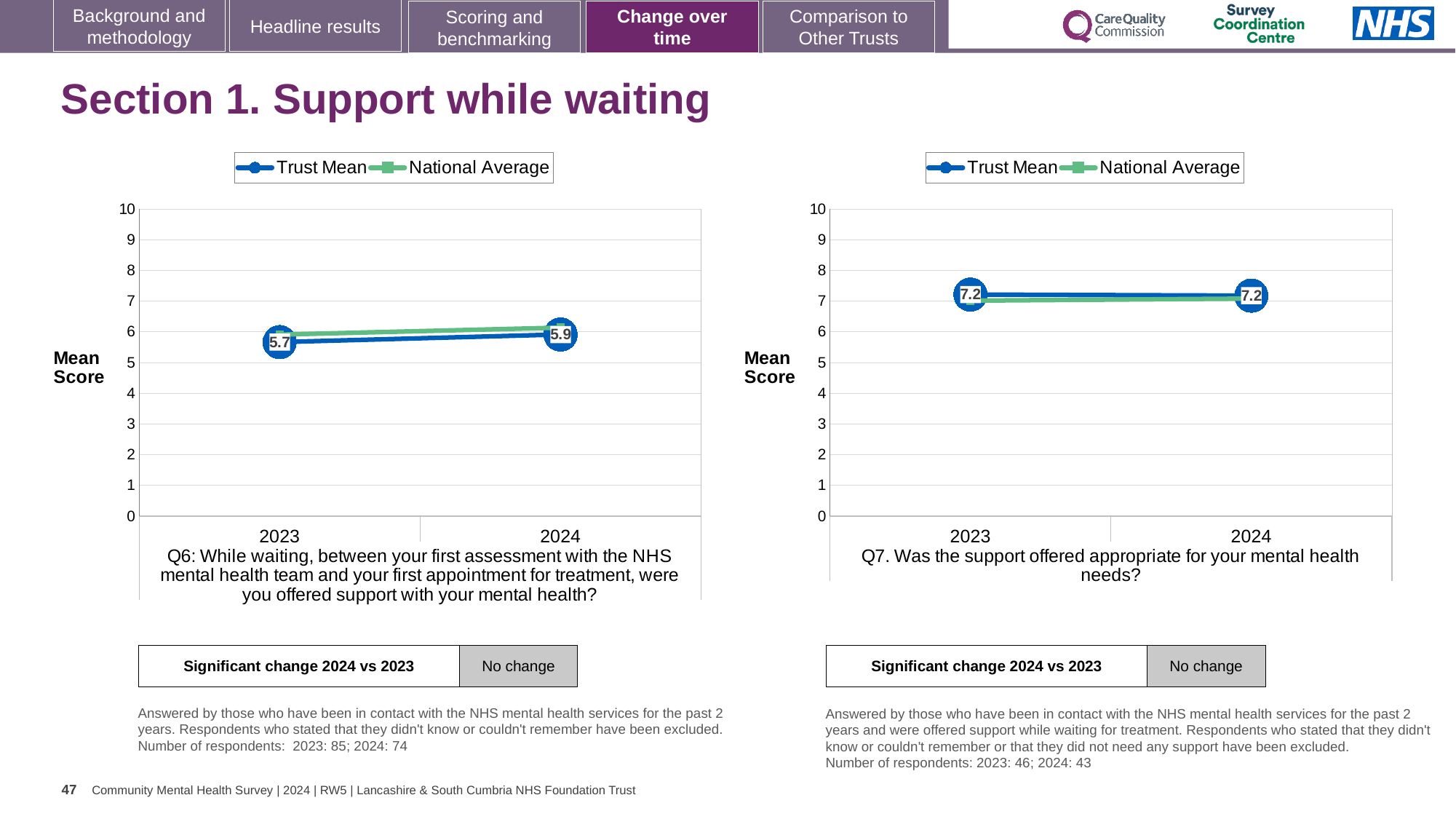
In the left chart (Q6), by how much did the Trust Mean change from 2023 to 2024? 0.2 In the right chart (Q7), does the Trust Mean rise, fall or stay the same from 2023 to 2024? stay the same In the left chart (Q6), what is the Trust Mean for 2023? 5.7 In the left chart (Q6), is the National Average for 2024 greater or less than 8? less How many series does the legend of the right chart (Q7) list? 2 In the left chart (Q6), does the Trust Mean rise or fall from 2023 to 2024? rise In the right chart (Q7), what is the Trust Mean for 2024? 7.2 What type of chart is the left chart (Q6)? line chart In the left chart (Q6), which year has the higher Trust Mean, 2023 or 2024? 2024 In the left chart (Q6), what is the Trust Mean for 2024? 5.9 How many years are shown on the x axis of the left chart (Q6)? 2 In the right chart (Q7), is the National Average for 2023 greater or less than 5? greater